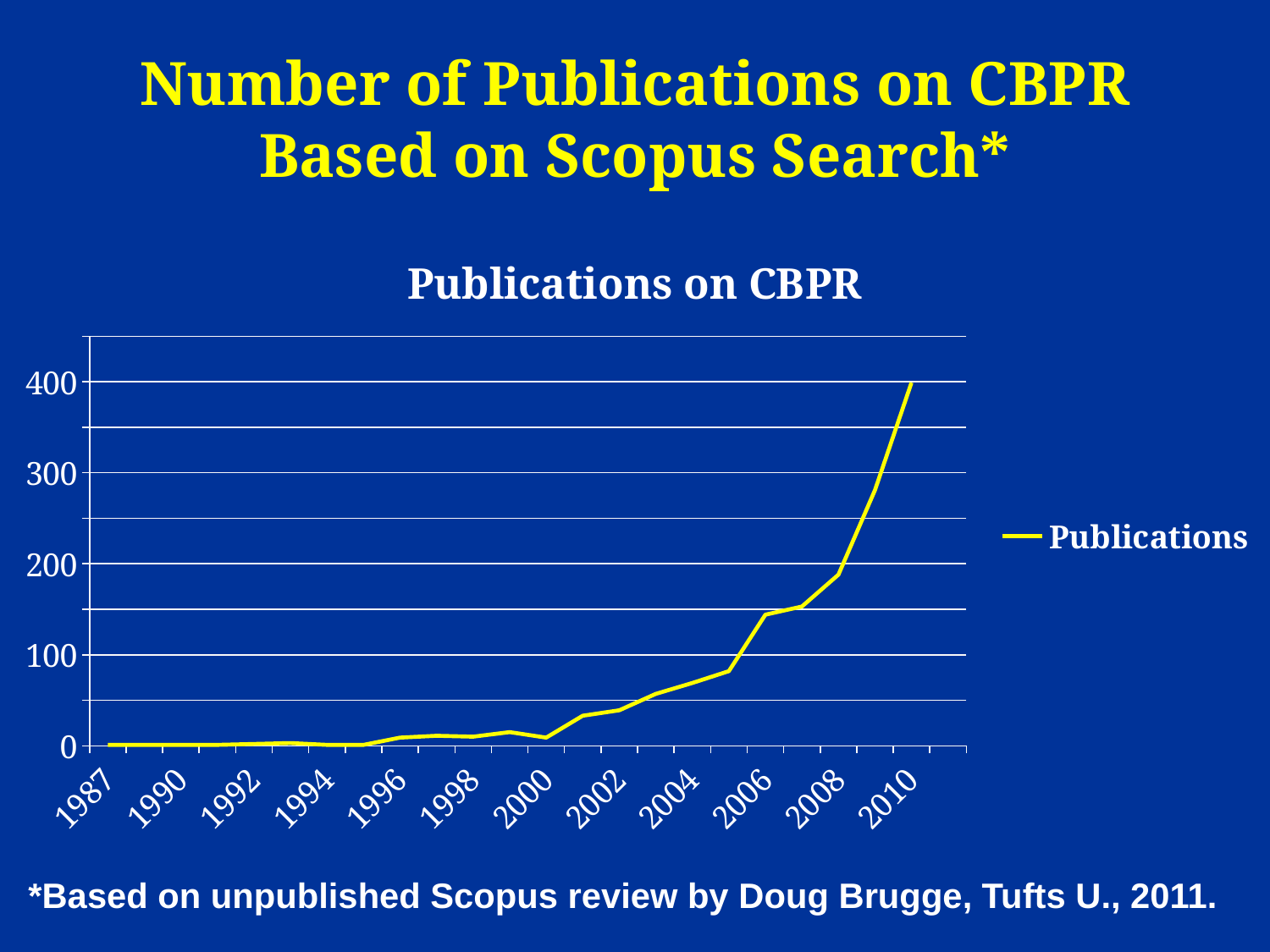
Is the value for 2004 greater or less than 100? less What is the title of the chart? Publications on CBPR Which year has the larger value, 2002 or 2008? 2008 Which year has the highest number of publications? 2010 How many series does the legend list? 1 Is the value for 2010 greater or less than 300? greater What is the name of the series shown in the legend? Publications Is the value for 2000 greater or less than 100? less What kind of chart is shown on the slide? line chart Do the values generally rise or fall from 1987 to 2010? rise